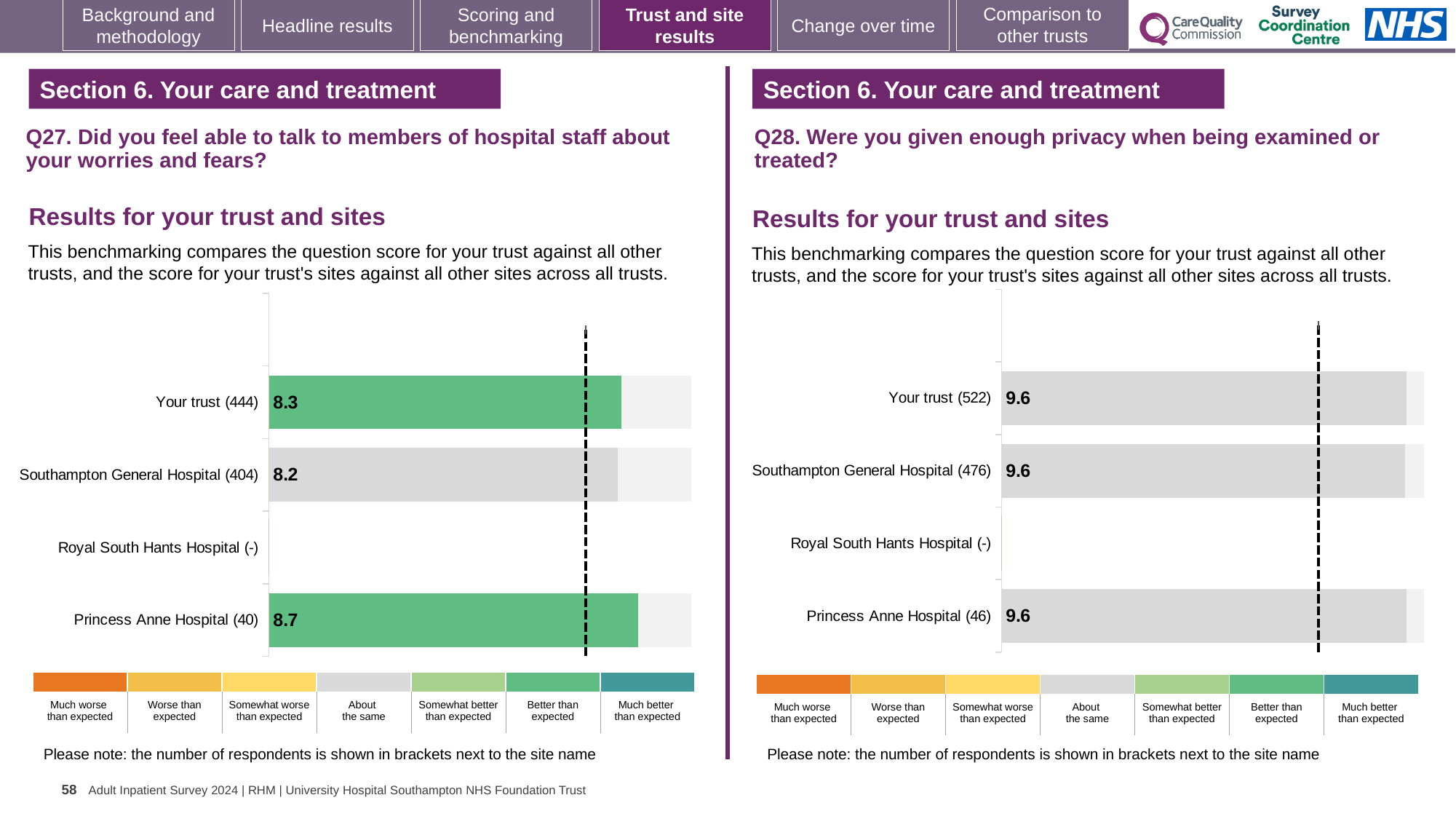
In the Q27 chart on the left, what is the score for Princess Anne Hospital (40)? 8.7 What kind of chart is the Q28 chart on the right? Bar chart How many categories are listed on the y axis of the Q27 chart on the left? 4 In the Q27 chart on the left, which site or trust has the highest score? Princess Anne Hospital (40) In the Q27 chart on the left, what is the score for Your trust (444)? 8.3 In the Q28 chart on the right, what is the difference between the scores for Your trust (522) and Southampton General Hospital (476)? 0 In the Q27 chart on the left, which has the larger score, Your trust (444) or Southampton General Hospital (404)? Your trust (444) In the Q27 chart on the left, which category has no score shown? Royal South Hants Hospital (-) In the Q28 chart on the right, what is the score for Princess Anne Hospital (46)? 9.6 In the Q28 chart on the right, what is the score for Your trust (522)? 9.6 In the Q27 chart on the left, what is the difference between the scores for Princess Anne Hospital (40) and Southampton General Hospital (404)? 0.5 In the Q27 chart on the left, what is the score for Southampton General Hospital (404)? 8.2